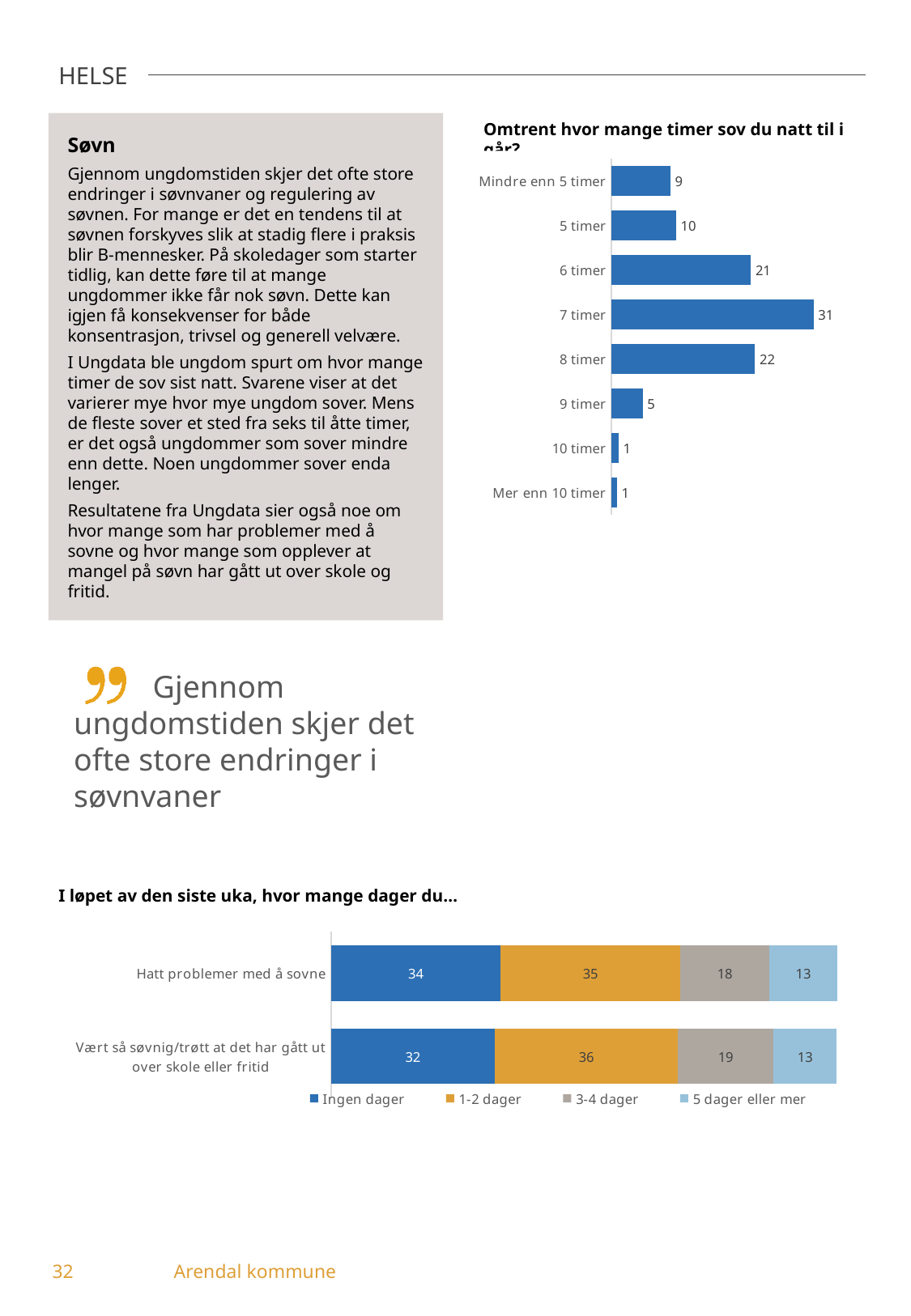
In the top-right chart about hours slept last night, what is the value for 'Mindre enn 5 timer'? 9 In the top-right chart about hours slept last night, what is the value for '7 timer'? 31 In the top-right chart about hours slept last night, what is the difference between the values for '8 timer' and '6 timer'? 1 In the bottom chart 'I løpet av den siste uka, hvor mange dager du…', which legend entry is shown in orange? 1-2 dager In the bottom chart 'I løpet av den siste uka, hvor mange dager du…', what is the total of the stacked bar for 'Hatt problemer med å sovne'? 100 In the bottom chart 'I løpet av den siste uka, hvor mange dager du…', what is the value for '1-2 dager' in the row 'Hatt problemer med å sovne'? 35 How many series does the legend list in the bottom chart 'I løpet av den siste uka, hvor mange dager du…'? 4 In the top-right chart about hours slept last night, which is larger: the value for '5 timer' or the value for '9 timer'? 5 timer What kind of chart is the top-right chart about hours slept last night? Bar chart How many categories are shown in the top-right chart about hours slept last night? 8 In the bottom chart 'I løpet av den siste uka, hvor mange dager du…', what is the value for 'Ingen dager' in the row 'Vært så søvnig/trøtt at det har gått ut over skole eller fritid'? 32 In the top-right chart about hours slept last night, which category has the highest value? 7 timer